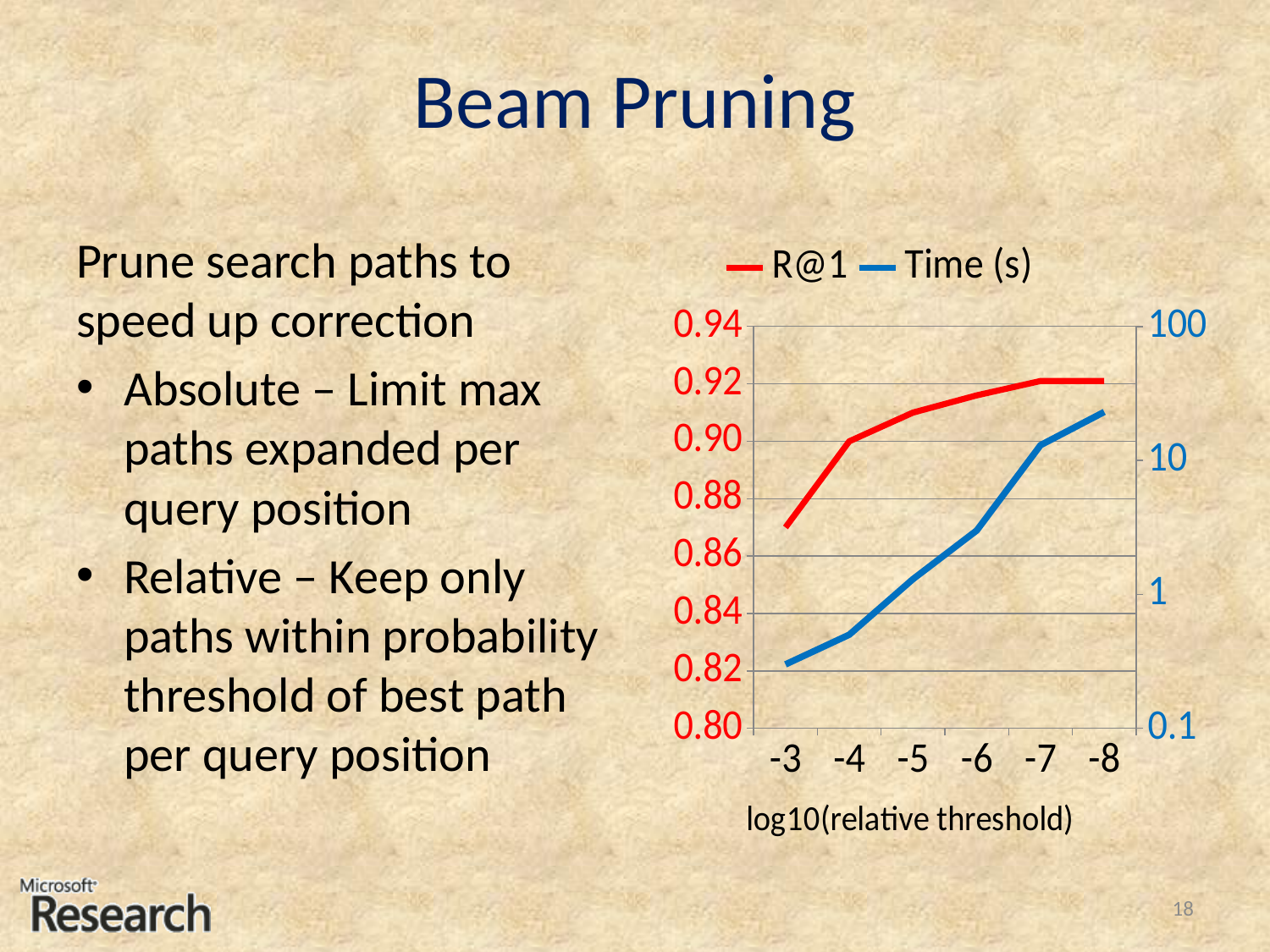
What is the x-axis title of the chart? log10(relative threshold) Which colour is used for the Time (s) series? blue How many series does the chart legend list? 2 Does the Time (s) series rise or fall as the x axis goes from -3 to -8? rise Is the Time (s) value at -3 greater or less than 1? less At which x-axis value is R@1 lowest? -3 Is the R@1 value at -8 greater or less than 0.90? greater Is the R@1 value at -3 greater or less than 0.88? less How many x-axis categories are plotted on the chart? 6 At which x-axis value is Time (s) highest? -8 What kind of chart is shown on the slide? line chart